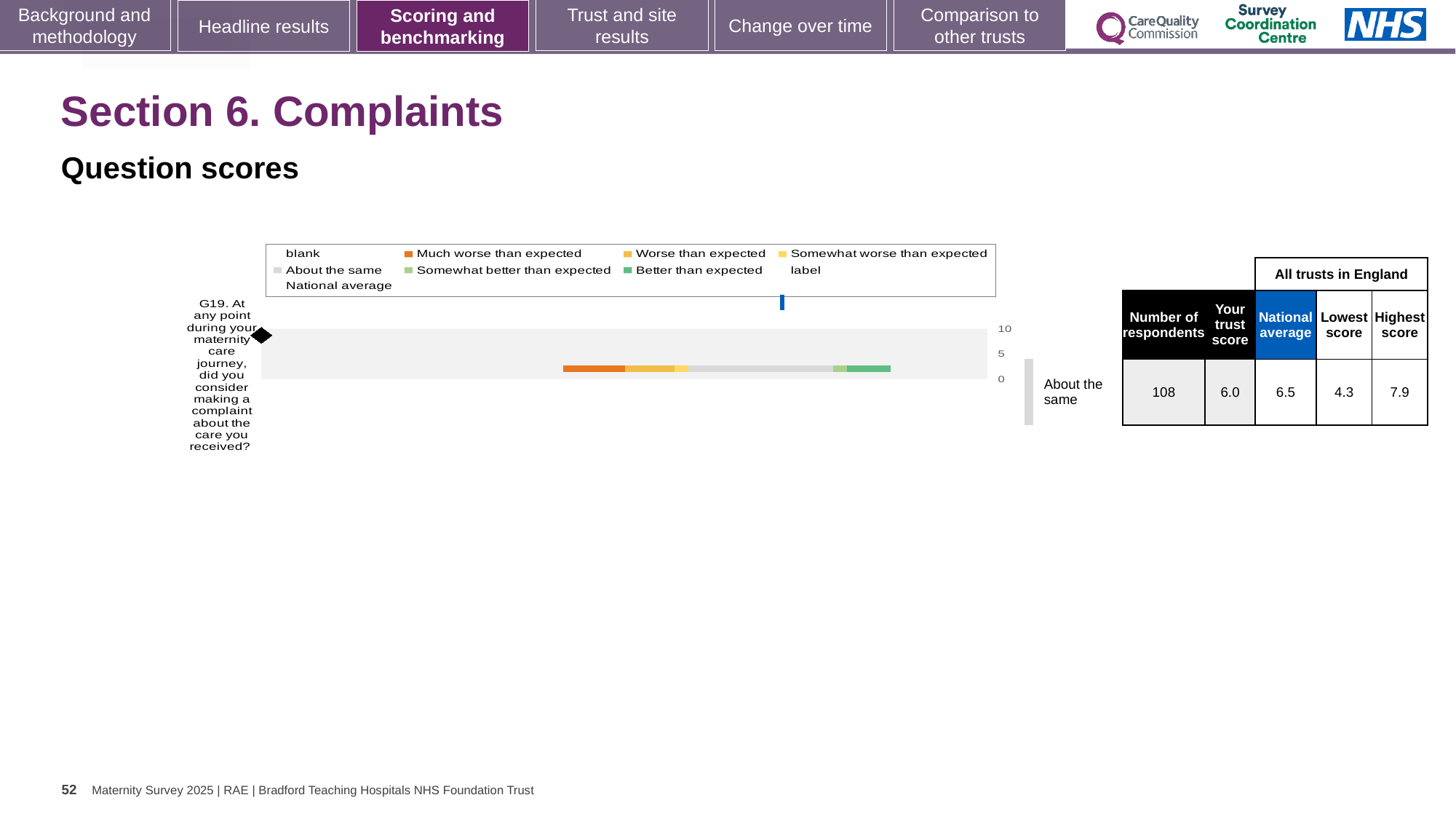
How many questions (categories) are plotted in the chart? 1 What benchmark category is shown to the right of the chart for G19? About the same In the table beside the chart, what is the trust score for G19? 6.0 In the table beside the chart, what is the lowest score among all trusts in England for G19? 4.3 In the table beside the chart, which is larger for G19: the trust score or the national average? national average What kind of chart is shown on the slide? bar chart In the table beside the chart, what is the highest score among all trusts in England for G19? 7.9 In the table beside the chart, what is the number of respondents for G19? 108 Which legend entry is shown in orange? Much worse than expected In the table beside the chart, what is the national average for G19? 6.5 Which question is plotted in the chart? G19. At any point during your maternity care journey, did you consider making a complaint about the care you received? In the table beside the chart, what is the difference between the highest score and the lowest score for G19? 3.6